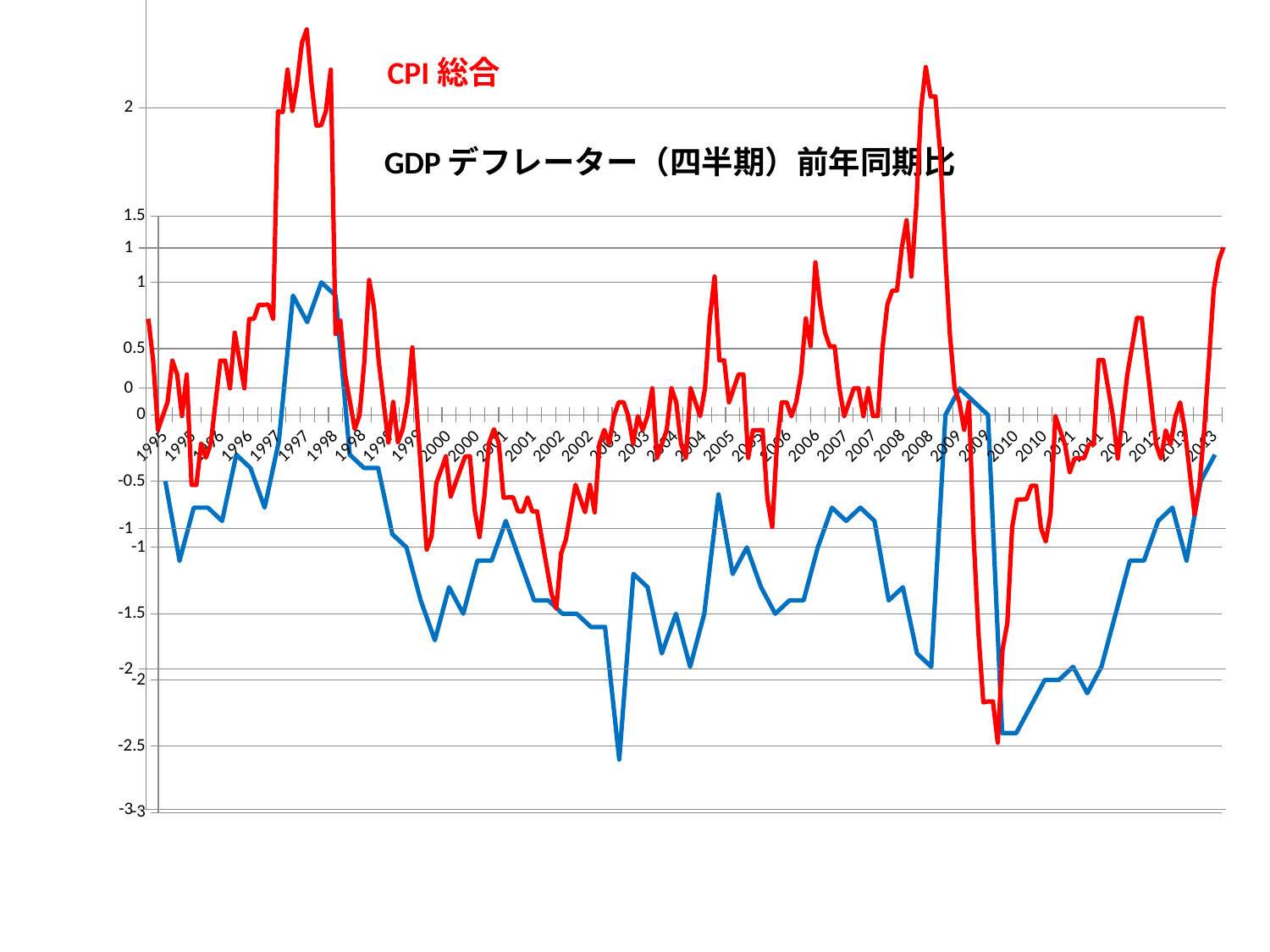
Which series does the blue line represent? GDP デフレーター（四半期）前年同期比 Which series reaches the highest value on the chart, CPI 総合 or GDP デフレーター（四半期）前年同期比? CPI 総合 Which series does the red line represent? CPI 総合 Around 2003, which line is lower, CPI 総合 or GDP デフレーター（四半期）前年同期比? GDP デフレーター（四半期）前年同期比 Around 2008, which line is higher, CPI 総合 or GDP デフレーター（四半期）前年同期比? CPI 総合 Does the GDP デフレーター（四半期）前年同期比 line rise or fall overall from 2010 to 2013? rise Is the value of the GDP デフレーター（四半期）前年同期比 line in 2003 greater or less than 0? less Is the peak value of the CPI 総合 line around 1997 greater or less than 2? greater What kind of chart is shown on the slide? line chart How many data series are plotted on the chart? 2 Does the CPI 総合 line rise or fall from 2012 to the end of 2013? rise Is the peak value of the CPI 総合 line around 2008 greater or less than 1? greater